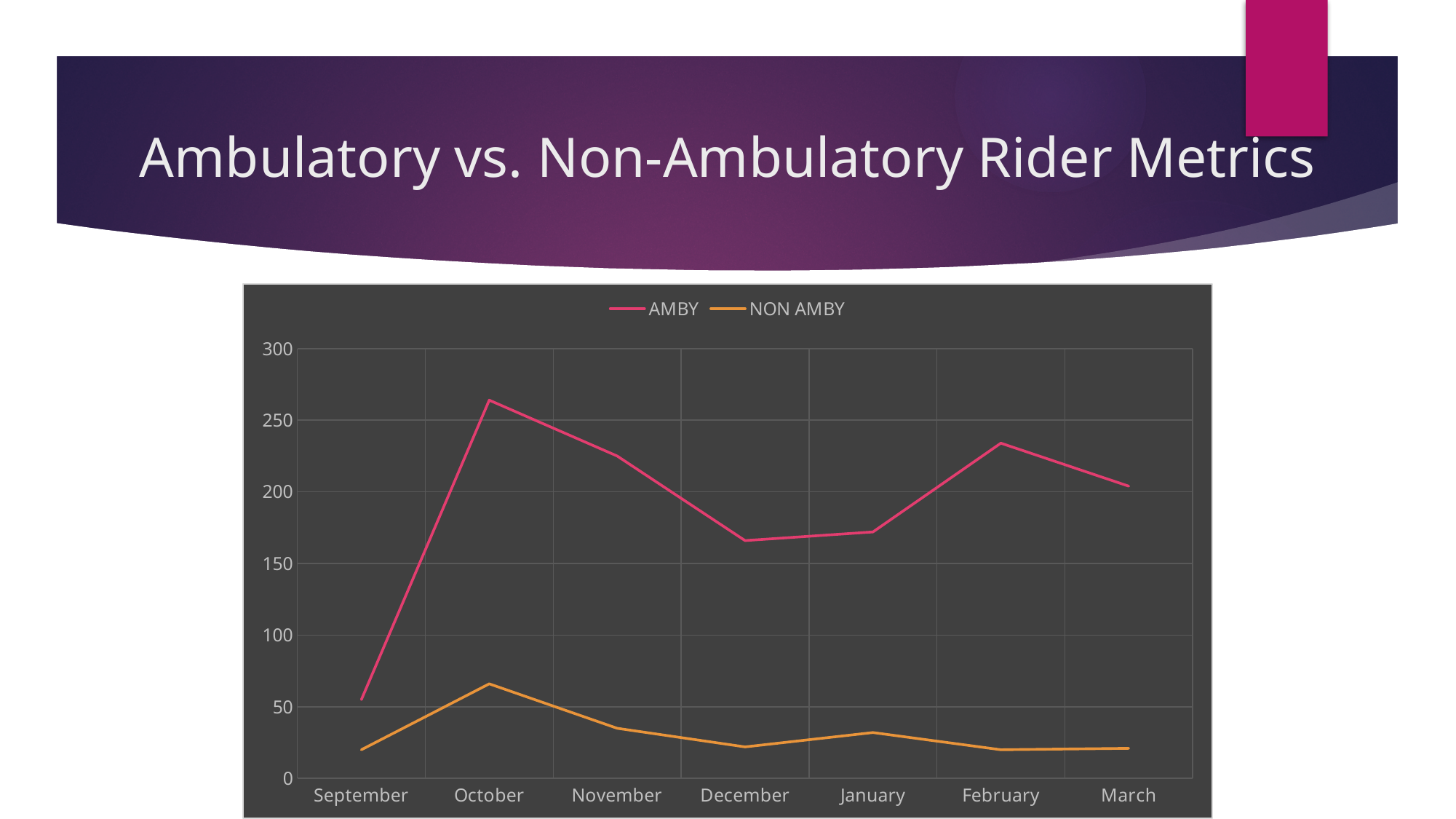
Is the AMBY value for October greater or less than 250? greater In which month does the AMBY series reach its highest value? October Is the AMBY value for December greater or less than 200? less How many series does the legend list? 2 Is the NON AMBY value for October greater or less than 50? greater Which is larger for the AMBY series: November or December? November In which month does the NON AMBY series reach its highest value? October What colour is the NON AMBY line? orange In which month is the AMBY series at its lowest value? September How many months are plotted along the x axis? 7 Does the AMBY series rise or fall from September to October? rise What kind of chart is shown on the slide? line chart